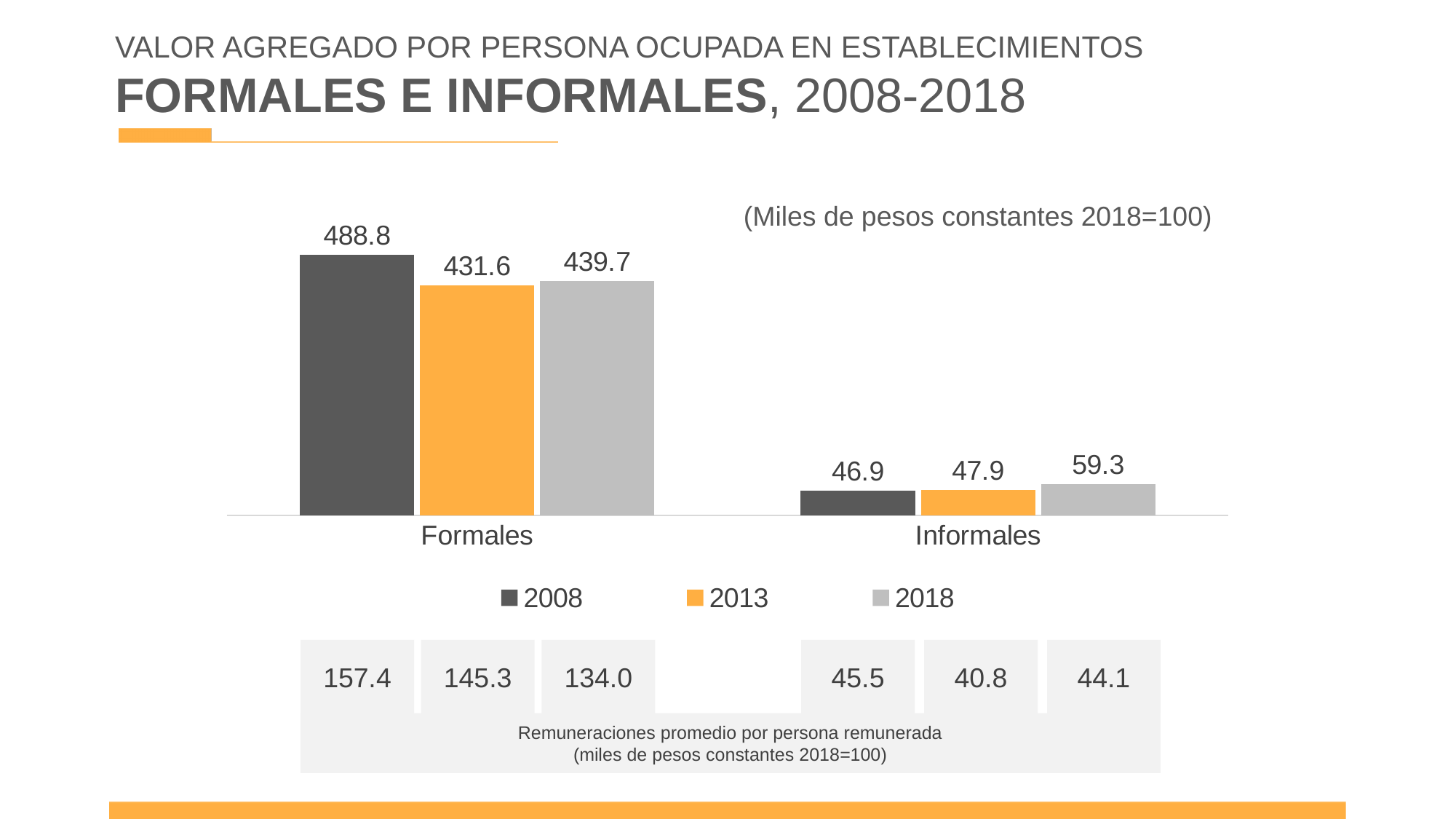
How many categories are shown on the x axis? 2 What is the difference between the Formales values for 2008 and 2018? 49.1 What is the value for Informales in 2018? 59.3 What unit is stated for the chart values? Miles de pesos constantes 2018=100 Which year has the highest value for Formales? 2008 Do the Informales values rise or fall from 2008 to 2018? rise What kind of chart is shown? bar chart What is the value for Formales in 2013? 431.6 Which year has the lowest value for Informales? 2008 Which is larger, the Formales value for 2013 or for 2018? 2018 What is the value for Formales in 2008? 488.8 How many series does the legend list? 3